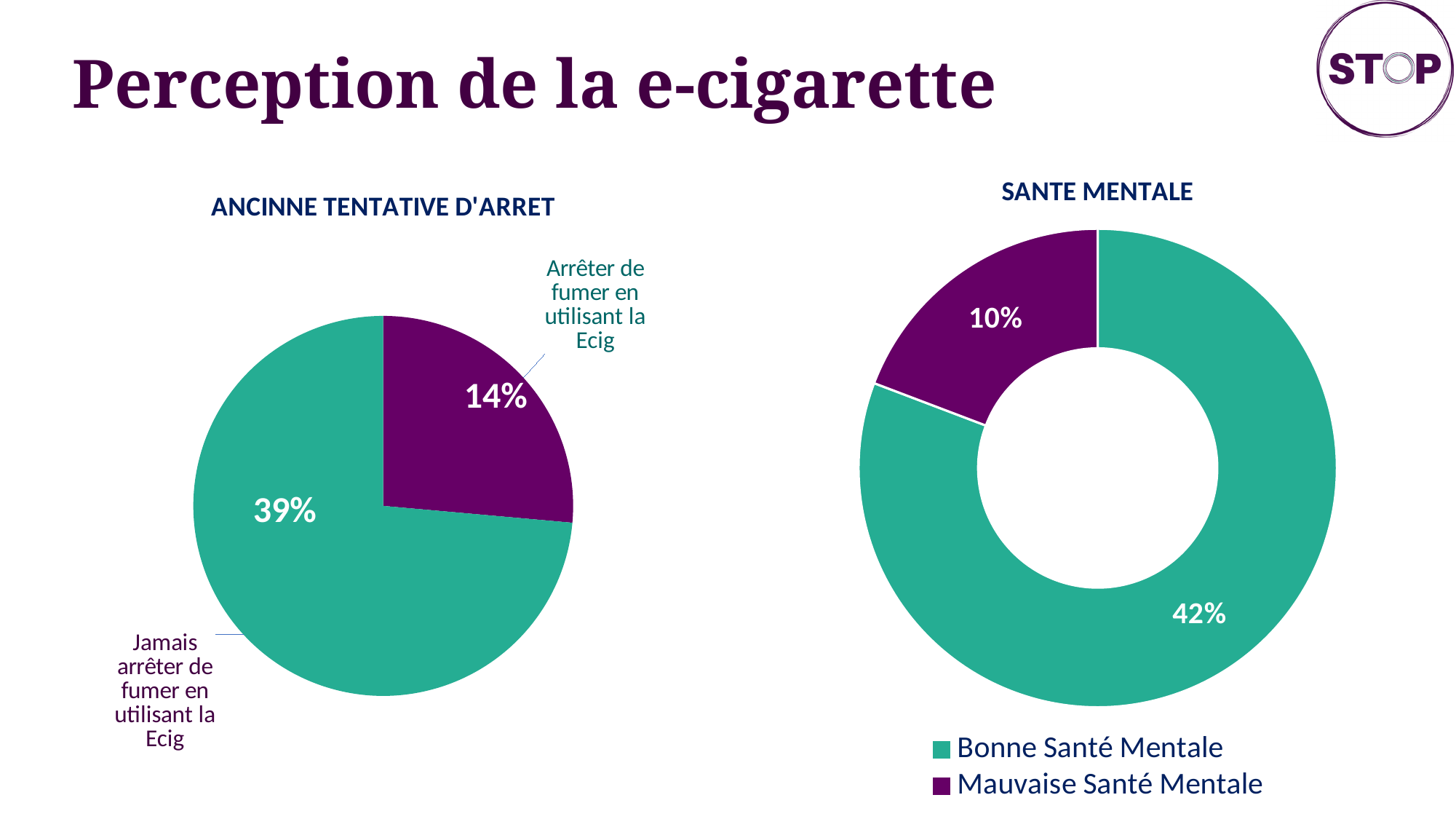
In the chart titled "ANCINNE TENTATIVE D'ARRET", what value is shown for "Jamais arrêter de fumer en utilisant la Ecig"? 39% In the chart titled "SANTE MENTALE", which is larger: "Bonne Santé Mentale" or "Mauvaise Santé Mentale"? Bonne Santé Mentale In the chart titled "SANTE MENTALE", which category has the smallest slice? Mauvaise Santé Mentale In the chart titled "ANCINNE TENTATIVE D'ARRET", what value is shown for "Arrêter de fumer en utilisant la Ecig"? 14% How many slices does the chart titled "ANCINNE TENTATIVE D'ARRET" have? 2 How many entries does the legend of the chart titled "SANTE MENTALE" list? 2 In the chart titled "ANCINNE TENTATIVE D'ARRET", what is the difference in percentage points between the two slices? 25 In the chart titled "SANTE MENTALE", what value is shown for "Bonne Santé Mentale"? 42% In the chart titled "ANCINNE TENTATIVE D'ARRET", which category has the largest slice? Jamais arrêter de fumer en utilisant la Ecig In the chart titled "SANTE MENTALE", what value is shown for "Mauvaise Santé Mentale"? 10% In the chart titled "SANTE MENTALE", what is the difference in percentage points between "Bonne Santé Mentale" and "Mauvaise Santé Mentale"? 32 What kind of chart is the chart titled "SANTE MENTALE"? Doughnut chart